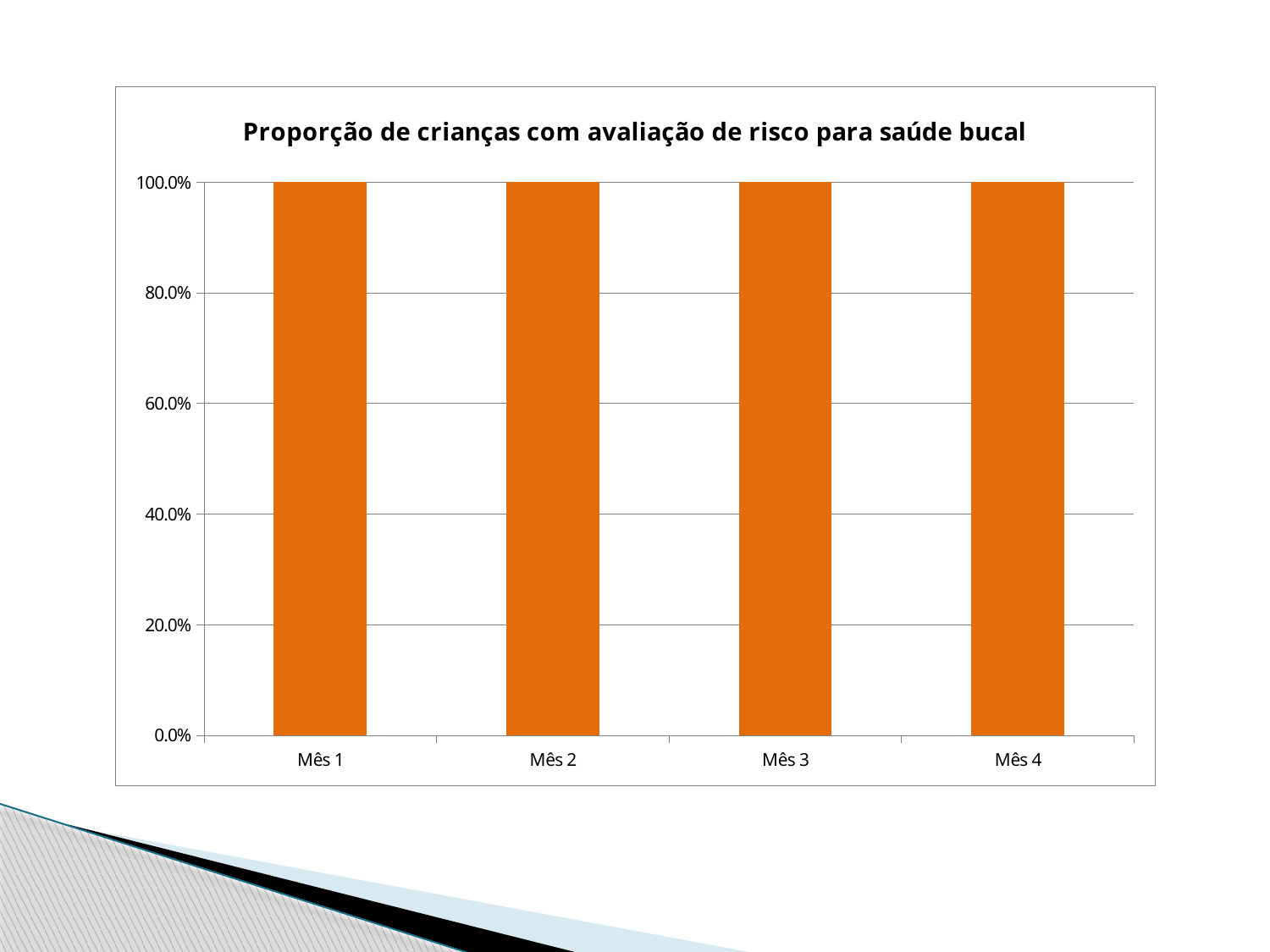
What is the difference between the values for Mês 1 and Mês 2? 0.0% What is the value for Mês 4? 100.0% Do the values rise, fall, or stay the same from Mês 1 to Mês 4? stay the same What colour are the bars in the chart? orange Is the value for Mês 4 greater or less than 60.0%? greater What is the value for Mês 1? 100.0% Is the value for Mês 2 greater or less than 80.0%? greater What is the title of the chart? Proporção de crianças com avaliação de risco para saúde bucal What kind of chart is shown on the slide? bar chart How many categories are shown on the x axis? 4 What is the label of the first category on the x axis? Mês 1 What is the value for Mês 3? 100.0%